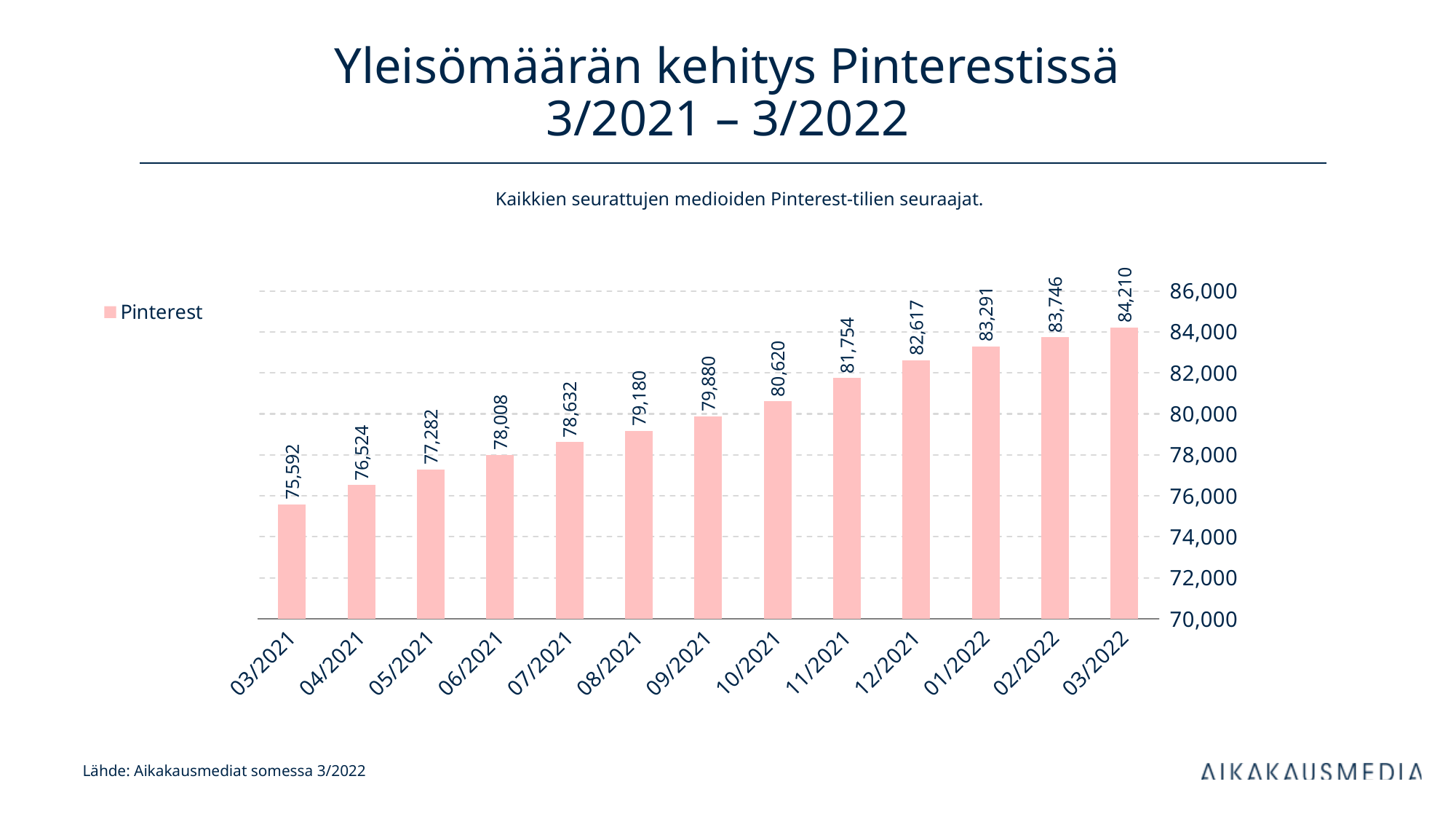
Which month has the lowest value? 03/2021 What kind of chart is shown on the slide? bar chart How many months are shown on the x axis? 13 Which month has the highest value? 03/2022 What is the value for 03/2021? 75,592 What is the difference between the values for 03/2022 and 03/2021? 8,618 What is the value for 10/2021? 80,620 Which is larger, the value for 07/2021 or the value for 09/2021? 09/2021 What is the difference between the values for 12/2021 and 11/2021? 863 What is the value for 03/2022? 84,210 Do the values rise or fall from 03/2021 to 03/2022? rise Is the value for 06/2021 greater or less than 80,000? less